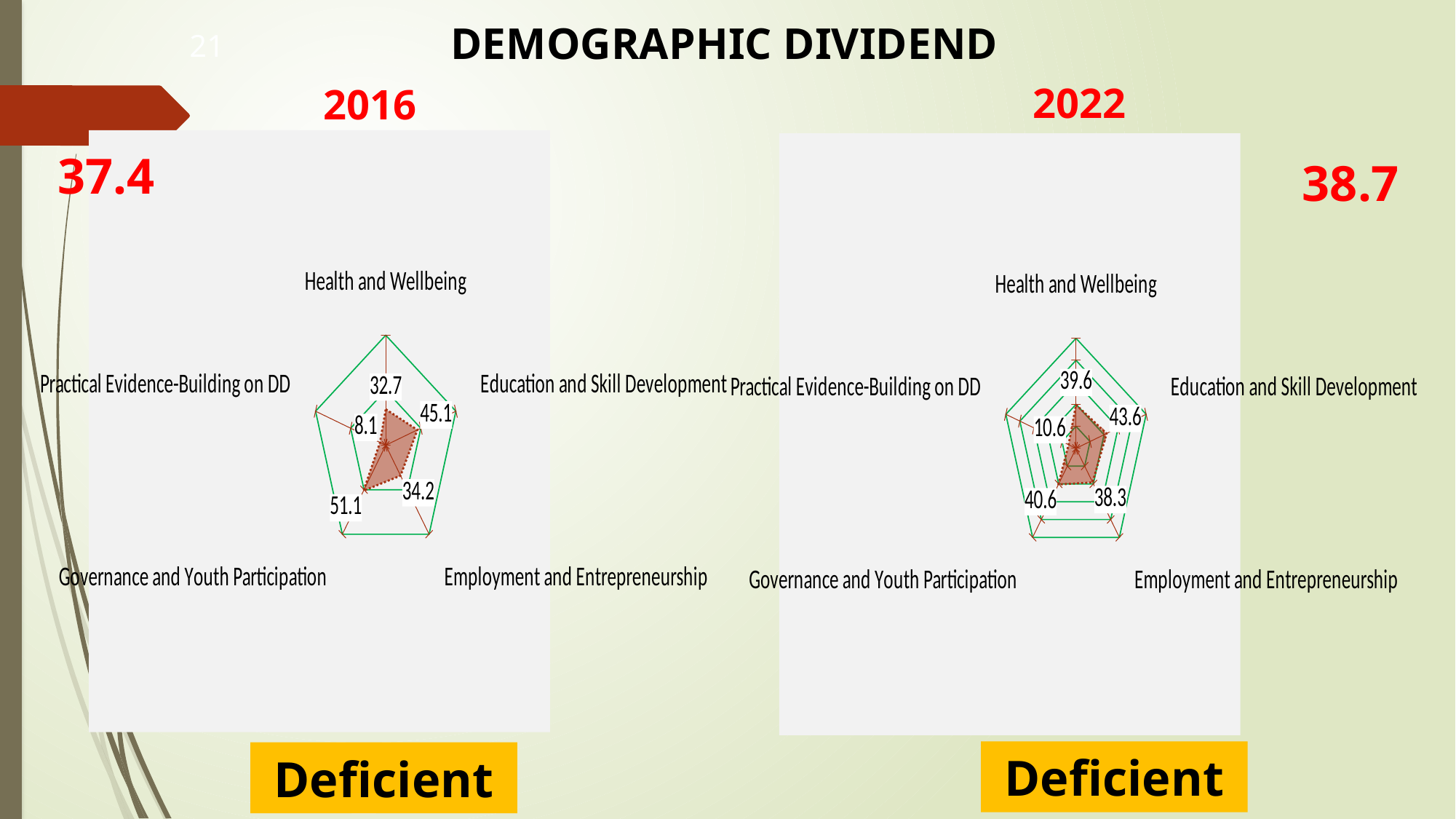
In the 2022 chart, which category has the lowest value? Practical Evidence-Building on DD In the 2016 chart, which category has the highest value? Governance and Youth Participation In the 2022 chart, which is larger: Health and Wellbeing or Employment and Entrepreneurship? Health and Wellbeing What type of chart is the 2022 chart? Radar chart In the 2022 chart, what is the value for Practical Evidence-Building on DD? 10.6 In the 2022 chart, what is the value for Education and Skill Development? 43.6 What is the overall score shown next to the 2022 chart? 38.7 In the 2016 chart, what is the value for Health and Wellbeing? 32.7 In the 2016 chart, what is the difference between Education and Skill Development and Employment and Entrepreneurship? 10.9 How many categories does the 2016 chart have? 5 In the 2016 chart, what is the value for Governance and Youth Participation? 51.1 In the 2022 chart, which category has the highest value? Education and Skill Development